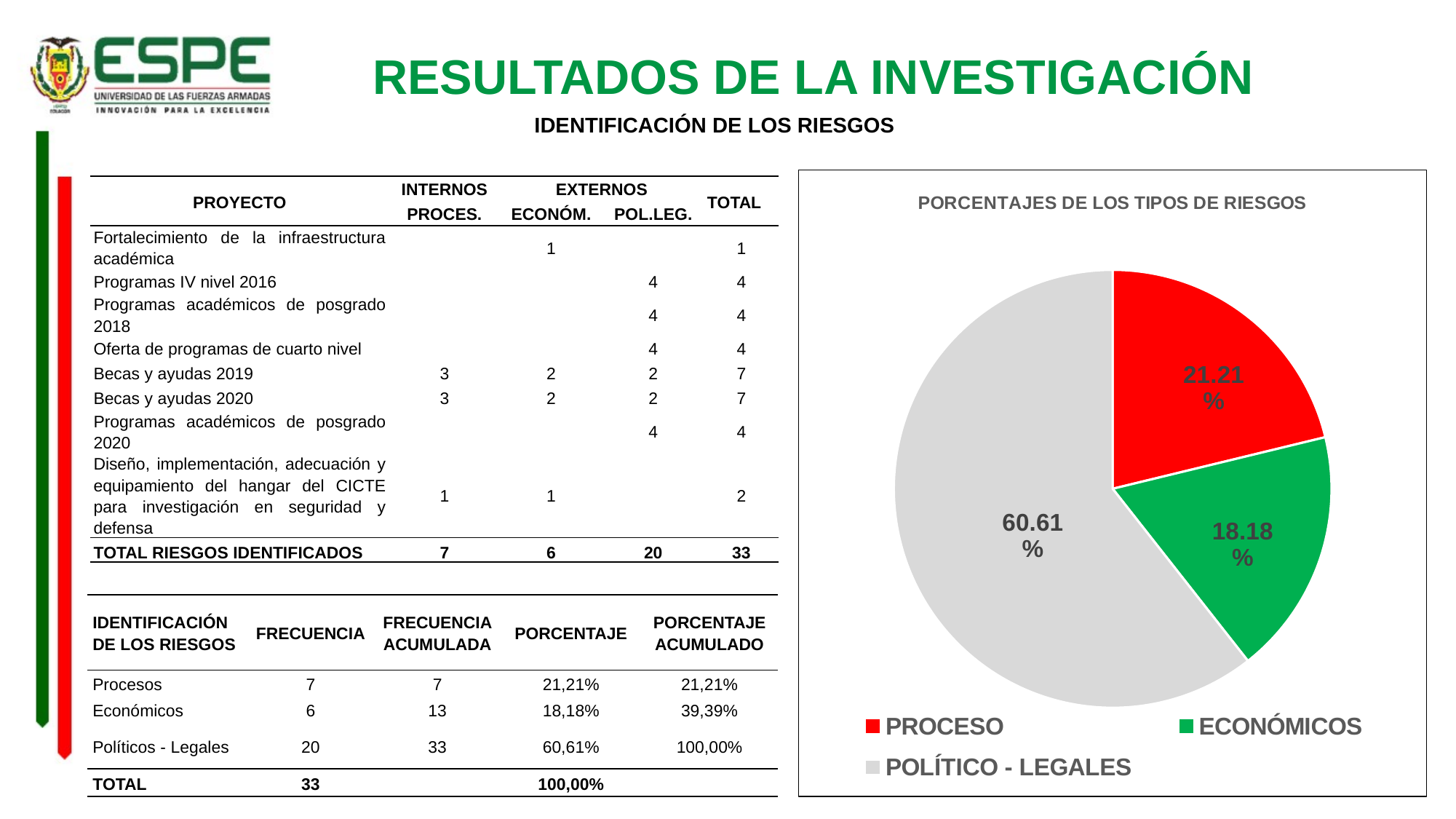
What is the title of the chart? PORCENTAJES DE LOS TIPOS DE RIESGOS Which slice is larger, PROCESO or ECONÓMICOS? PROCESO What percentage does the POLÍTICO - LEGALES slice show? 60.61% What is the difference in percentage points between the PROCESO and ECONÓMICOS slices? 3.03% What type of chart is shown on the slide? pie chart What colour is the POLÍTICO - LEGALES slice? grey How many slices does the pie chart have? 3 Which category has the largest slice of the pie? POLÍTICO - LEGALES What percentage does the ECONÓMICOS slice show? 18.18% Which category has the smallest slice of the pie? ECONÓMICOS What percentage does the PROCESO slice show? 21.21% How many entries does the legend list? 3